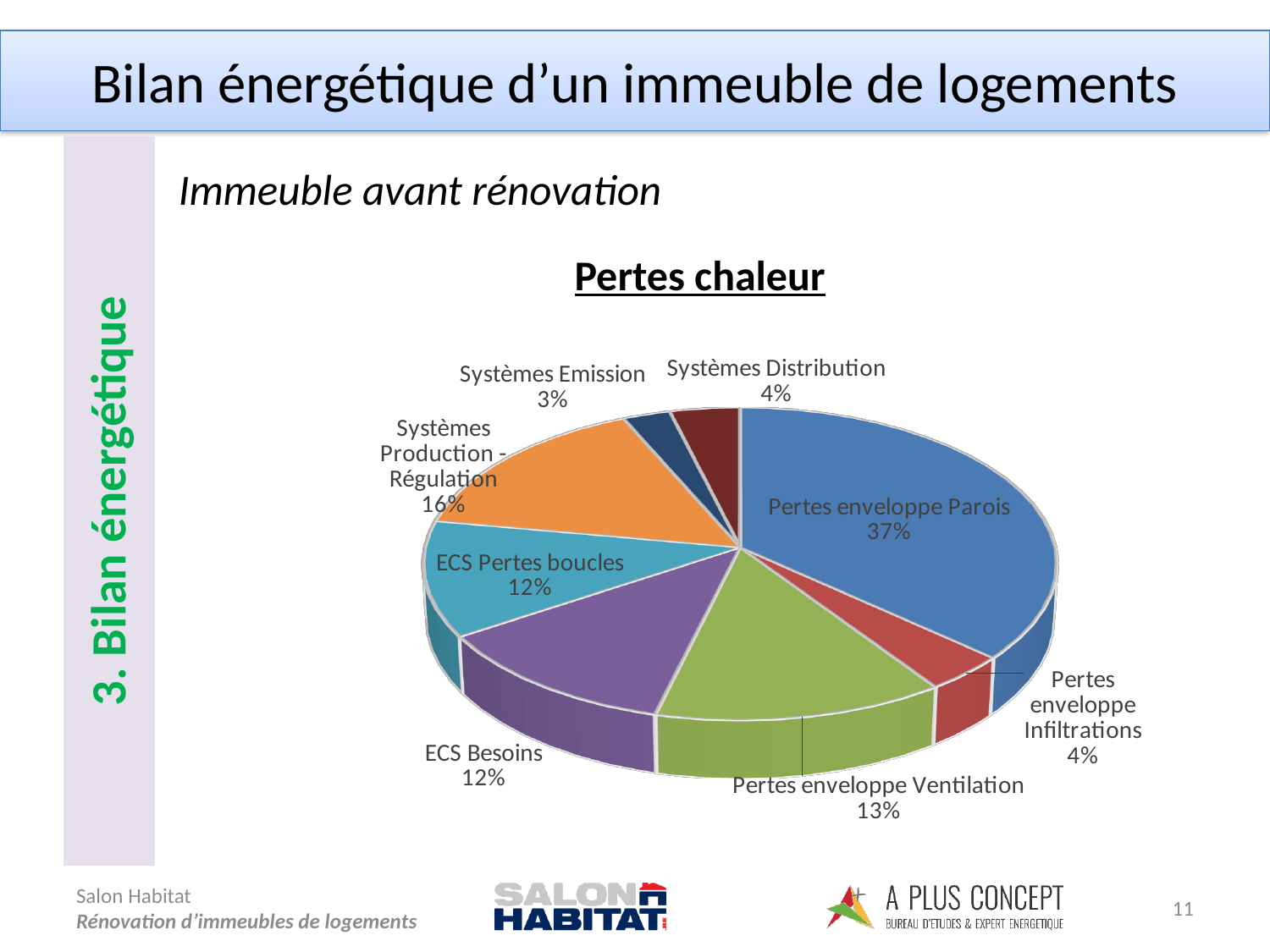
What is the value for Pertes enveloppe Ventilation? 13% Which is larger, Pertes enveloppe Ventilation or ECS Besoins? Pertes enveloppe Ventilation What is the value for Systèmes Production - Régulation? 16% What is the value for ECS Pertes boucles? 12% What is the difference between Pertes enveloppe Parois and Systèmes Production - Régulation? 21% What is the title of the chart? Pertes chaleur Which category has the largest slice of the pie? Pertes enveloppe Parois How many slices does the pie chart have? 8 What share of the pie is Pertes enveloppe Parois? 37% Which category has the smallest slice of the pie? Systèmes Emission What kind of chart is shown on the slide? pie chart What is the value for Systèmes Distribution? 4%